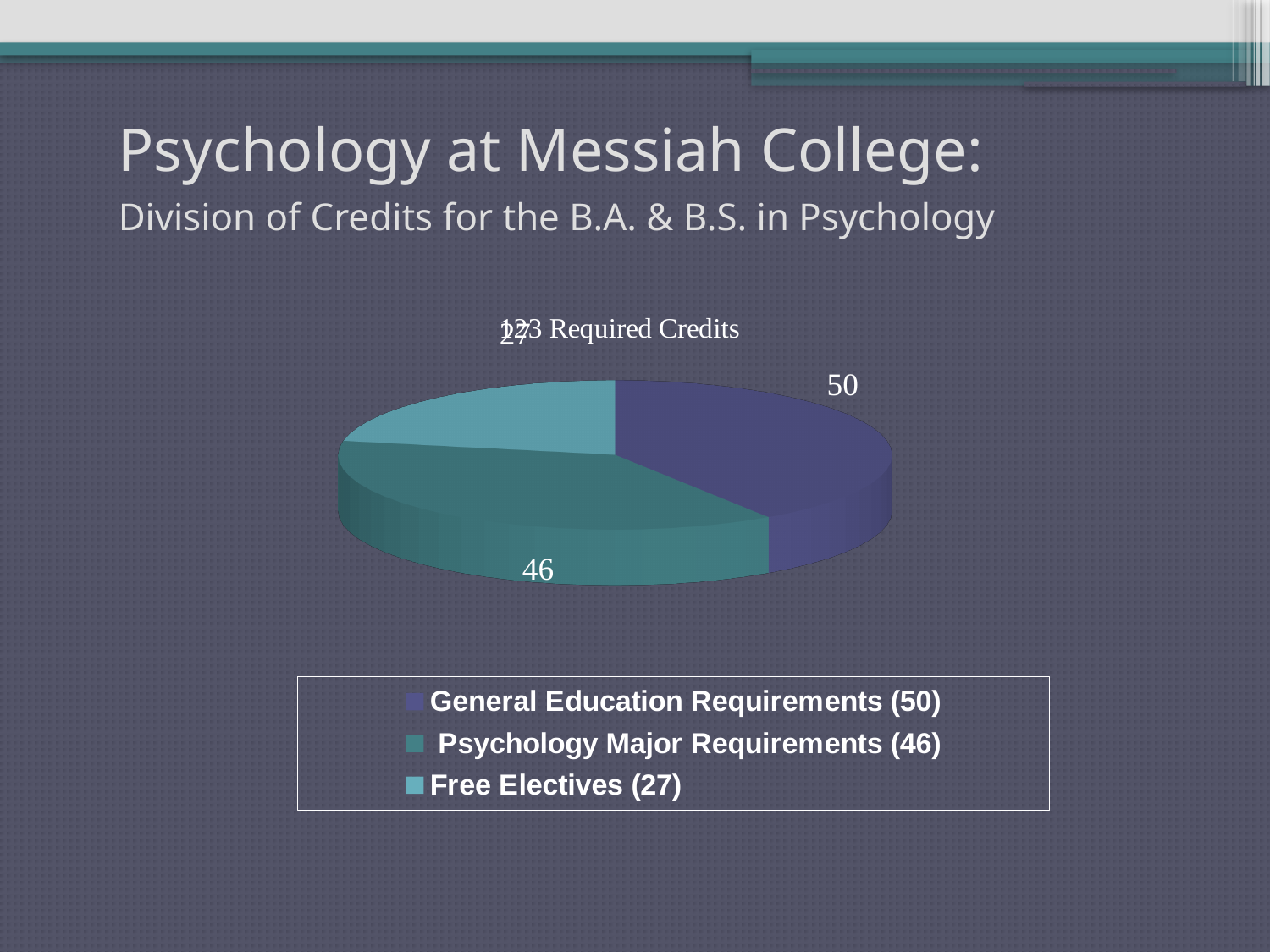
How many credits are shown for General Education Requirements? 50 How many entries does the legend list? 3 Which category has the largest slice of the pie? General Education Requirements What kind of chart is shown on the slide? Pie chart Which has more credits, Psychology Major Requirements or Free Electives? Psychology Major Requirements How many slices does the pie chart have? 3 Which category has the smallest slice of the pie? Free Electives What is the title of the pie chart? 123 Required Credits How many credits are shown for Psychology Major Requirements? 46 What is the difference in credits between General Education Requirements and Free Electives? 23 What is the total number of credits across all three slices? 123 How many credits are shown for Free Electives? 27